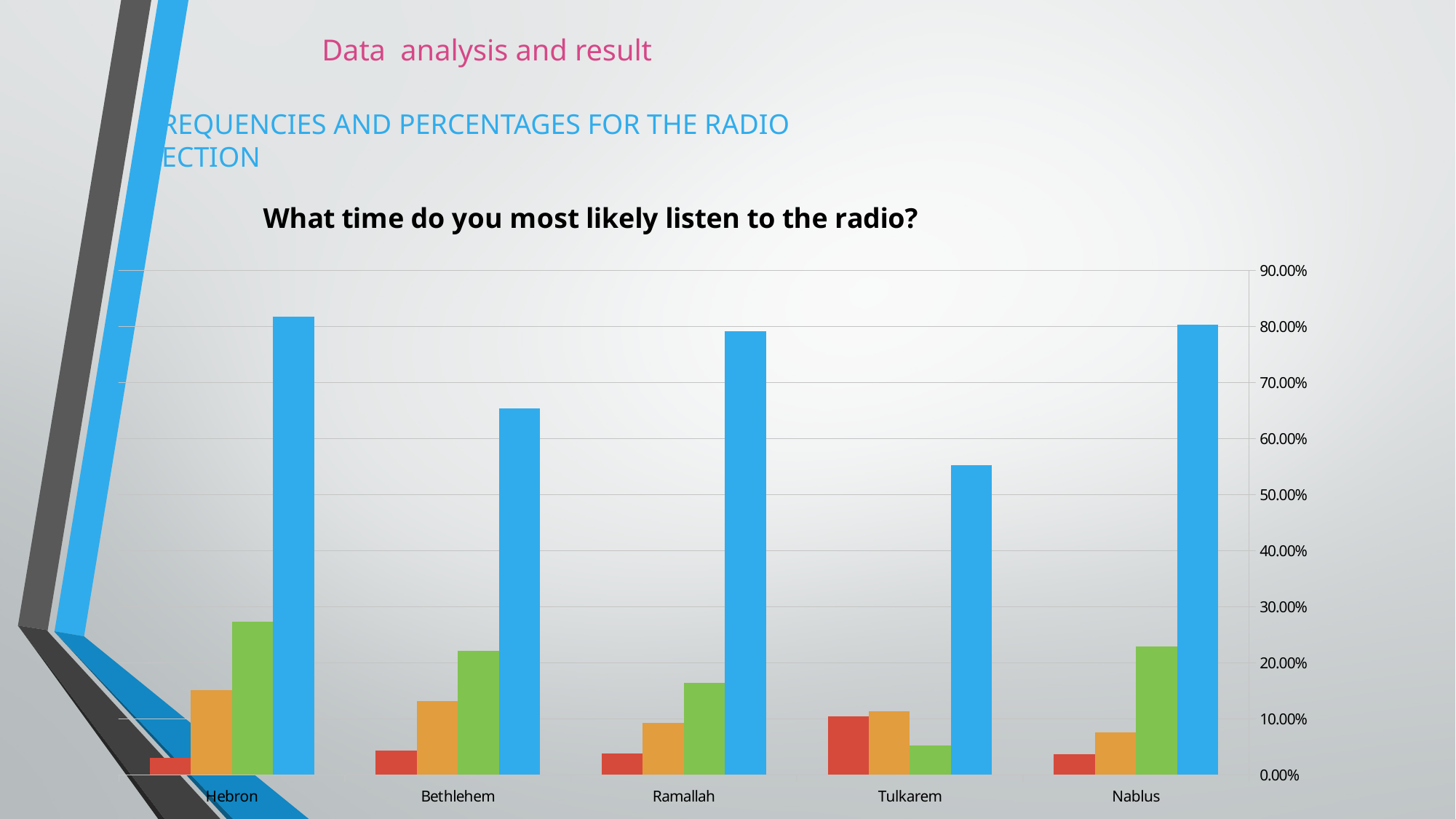
What is the title of the chart? What time do you most likely listen to the radio? Which city has the lowest blue bar in the chart? Tulkarem What kind of chart is shown on the slide? bar chart Is the blue bar for Tulkarem greater or less than 50.00%? greater How many bars are plotted for each city in the chart? 4 How many cities (categories) are shown on the x axis of the chart? 5 Which is larger, the blue bar for Bethlehem or the blue bar for Tulkarem? Bethlehem Is the blue bar for Bethlehem greater or less than 70.00%? less Is the green bar for Ramallah greater or less than 20.00%? less Which city has the highest red bar in the chart? Tulkarem Which city has the highest green bar in the chart? Hebron Which city has the lowest green bar in the chart? Tulkarem